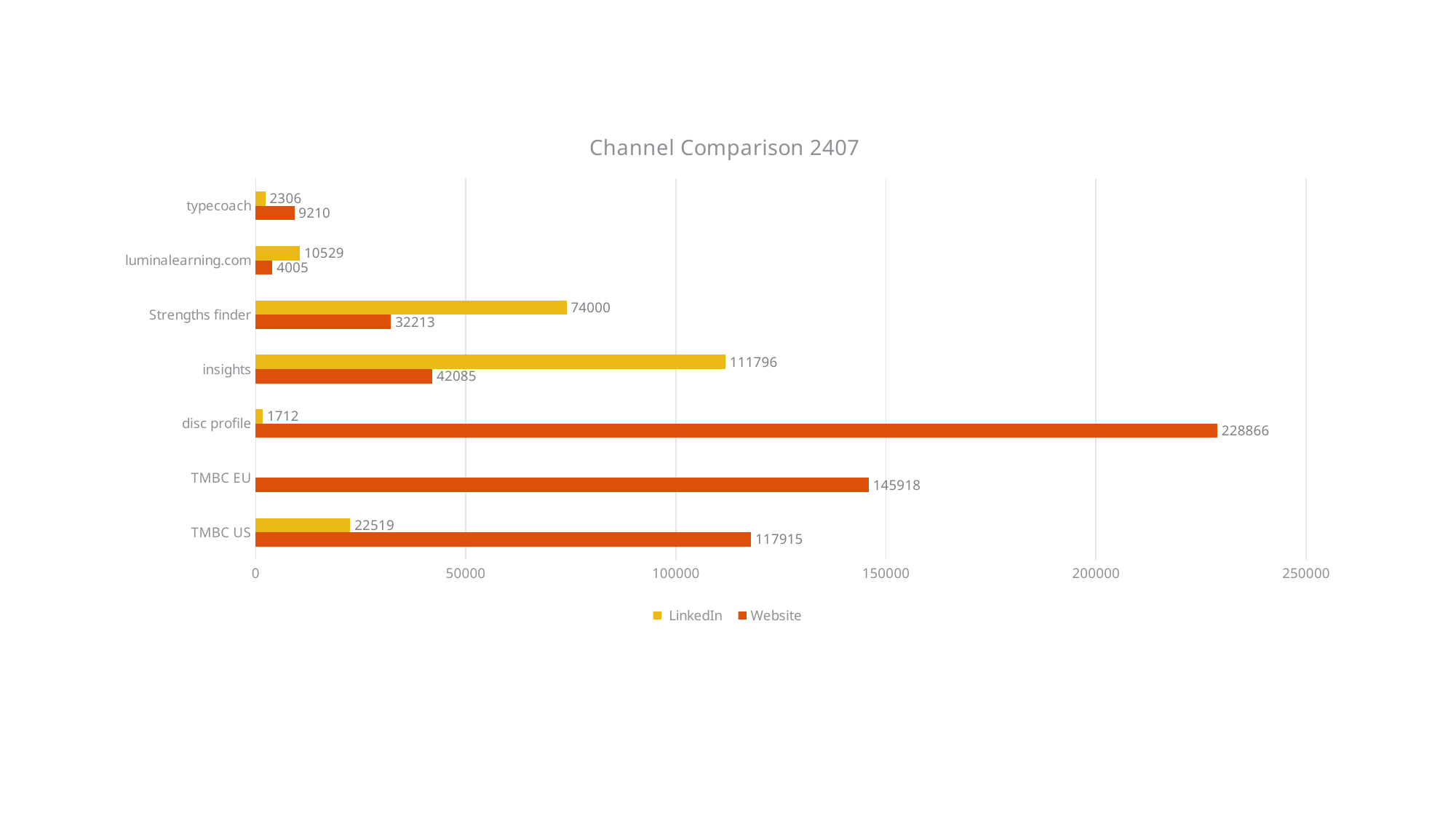
What kind of chart is shown? bar chart How many series does the legend list? 2 What is the Website value for TMBC EU? 145918 Which category has the lowest LinkedIn value? disc profile Which category has the highest Website value? disc profile What is the title of the chart? Channel Comparison 2407 How many categories are shown on the y axis? 7 What is the Website value for disc profile? 228866 What is the difference between the Website and LinkedIn values for TMBC US? 95396 What is the LinkedIn value for Strengths finder? 74000 Which is larger for luminalearning.com, the LinkedIn value or the Website value? LinkedIn Is the Website value for insights greater or less than 50000? less